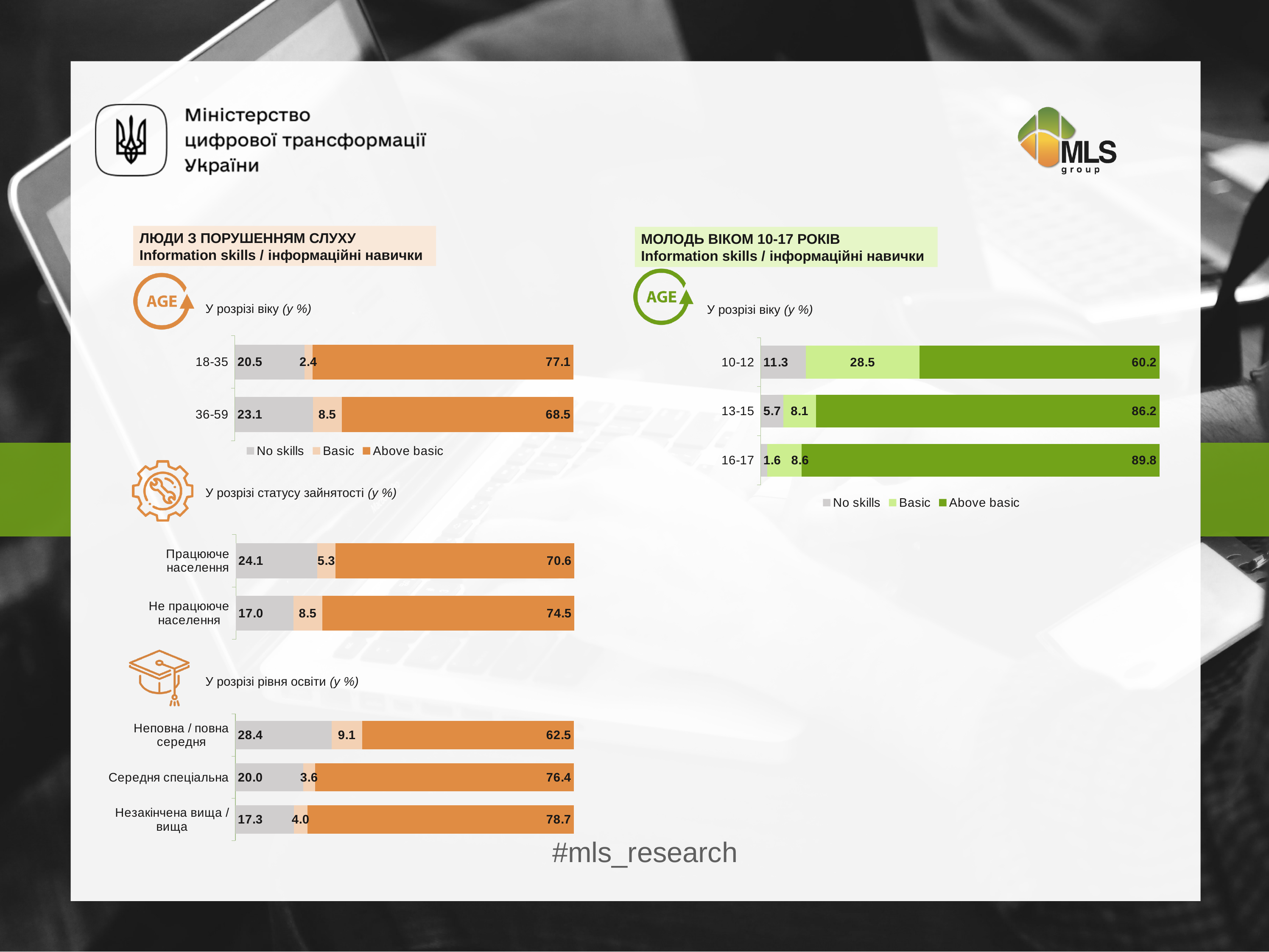
How many series does the legend list in the age chart for youth aged 10-17 (right)? 3 In the age chart for youth aged 10-17 (right), what is the 'No skills' value for the 10-12 group? 11.3 In the age chart for people with hearing impairment (left), what is the difference between the 'Above basic' values for 18-35 and 36-59? 8.6 In the age chart for people with hearing impairment (left, 'У розрізі віку'), what is the 'Above basic' value for the 18-35 group? 77.1 In the education level chart for people with hearing impairment (left, 'У розрізі рівня освіти'), what is the 'No skills' value for Неповна / повна середня? 28.4 In the employment status chart for people with hearing impairment (left, 'У розрізі статусу зайнятості'), which group has the larger 'Above basic' value: Працююче населення or Не працююче населення? Не працююче населення In the education level chart for people with hearing impairment (left), which education level has the highest 'Above basic' value? Незакінчена вища / вища In the age chart for youth aged 10-17 (right), which age group has the lowest 'Basic' value? 13-15 In the age chart for youth aged 10-17 (right), which age group has the highest 'Above basic' value? 16-17 How many age groups are shown in the age chart for youth aged 10-17 (right)? 3 In the age chart for youth aged 10-17 (right), what is the total of the stacked bar for the 13-15 group? 100.0 What kind of chart is the age chart for people with hearing impairment (left)? Stacked bar chart